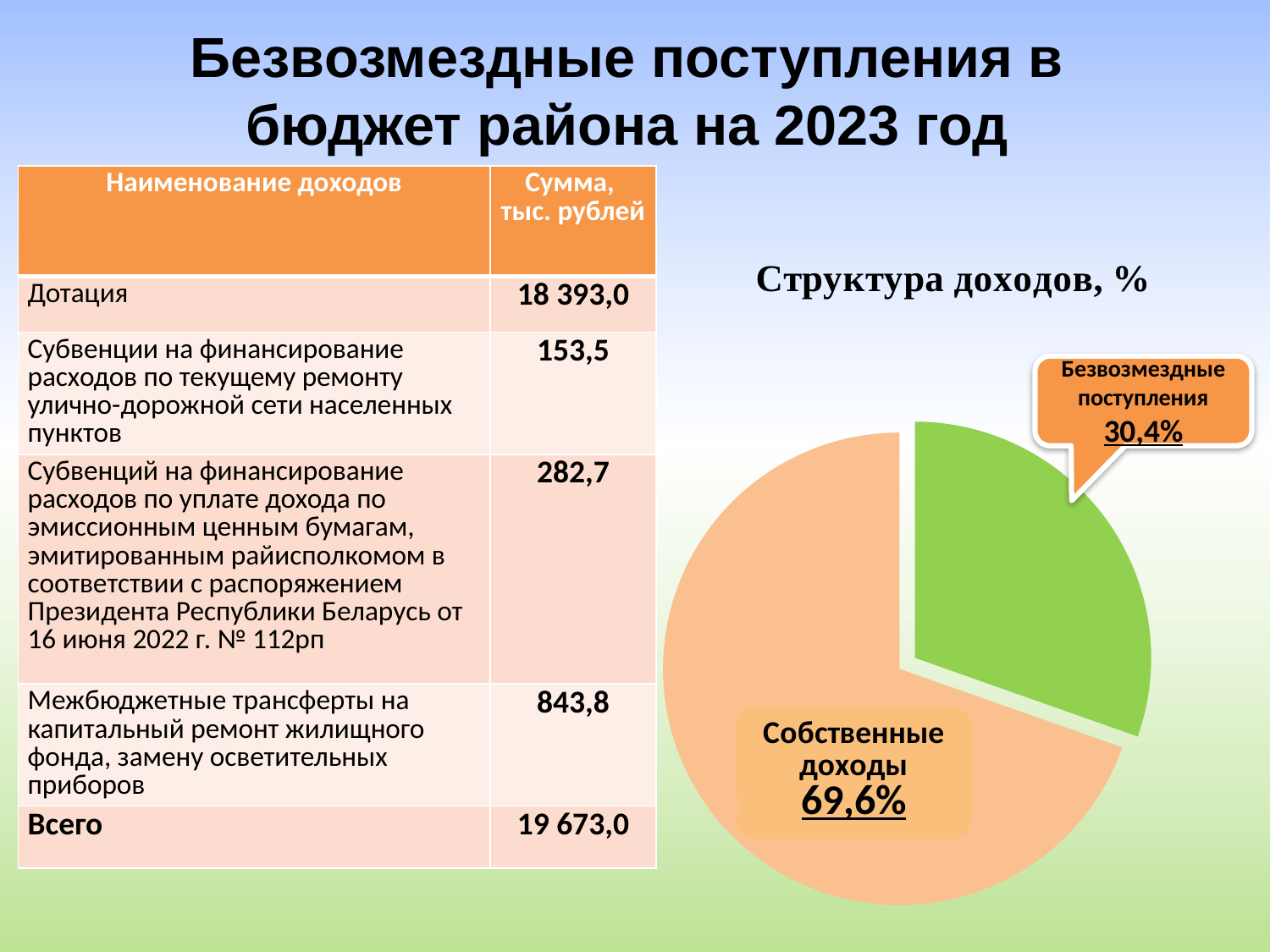
Which slice of the pie chart is the smallest? Безвозмездные поступления How many slices does the pie chart have? 2 Which slice of the pie chart is the largest? Собственные доходы What share of the pie does Безвозмездные поступления have? 30,4% What colour is the Безвозмездные поступления slice in the pie chart? green Which is larger in the pie chart, Собственные доходы or Безвозмездные поступления? Собственные доходы What is the difference in percentage points between Собственные доходы and Безвозмездные поступления in the pie chart? 39,2 What is the title of the chart on the slide? Структура доходов, % What type of chart is shown on the slide? pie chart What share of the pie does Собственные доходы have? 69,6%